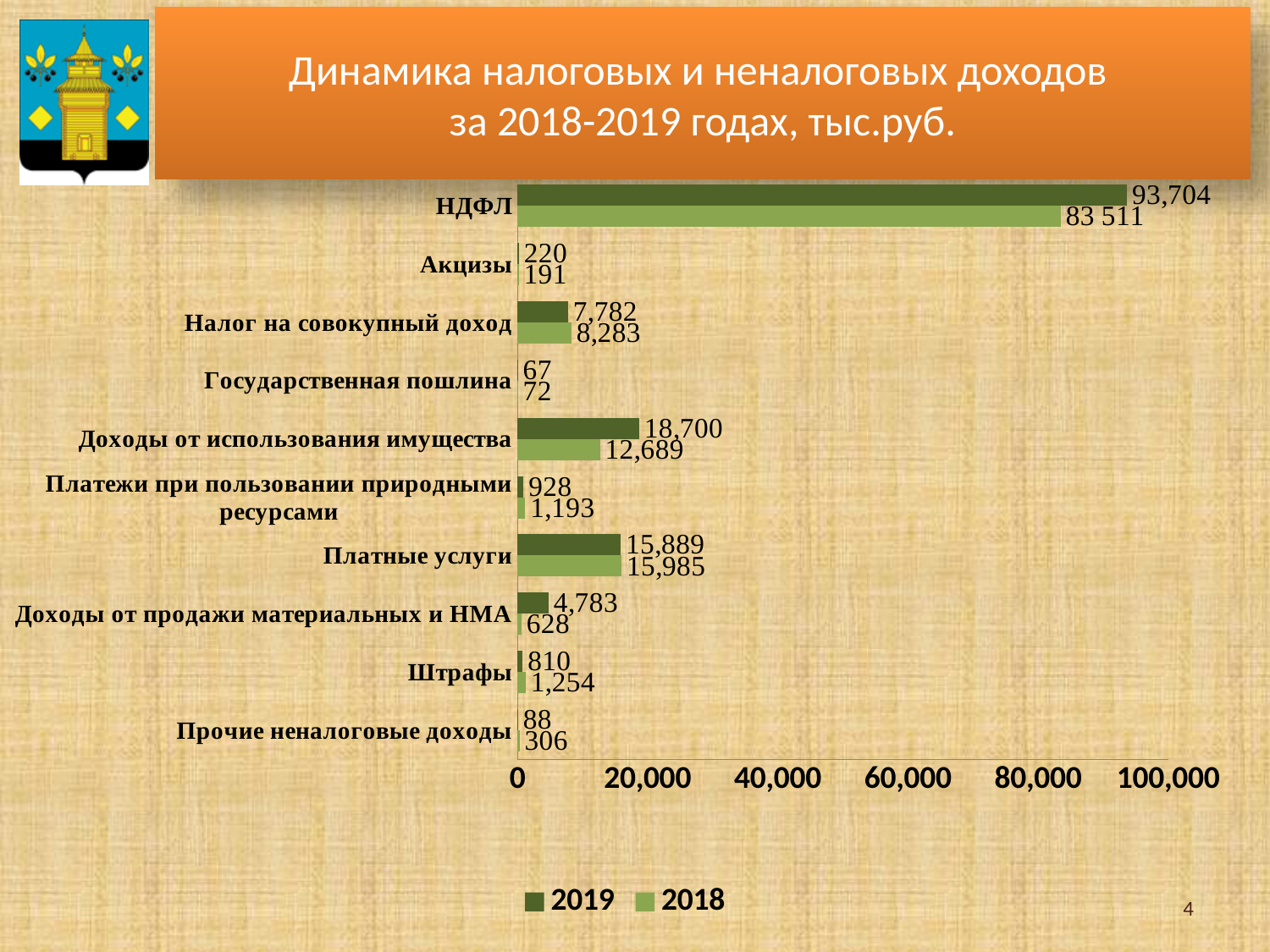
Which category has the lowest 2019 value? Государственная пошлина Is the 2018 value for НДФЛ greater or less than 80,000? greater What type of chart is shown on the slide? bar chart Which is larger for Штрафы: the 2019 value or the 2018 value? 2018 What is the 2018 value for Доходы от использования имущества? 12,689 Which category has the highest 2019 value? НДФЛ Which series is shown in dark green in the legend? 2019 How many series does the legend list? 2 What is the difference between the 2019 and 2018 values for Доходы от использования имущества? 6,011 How many categories are shown on the chart? 10 What is the 2019 value for Доходы от продажи материальных и НМА? 4,783 What is the 2019 value for НДФЛ? 93,704